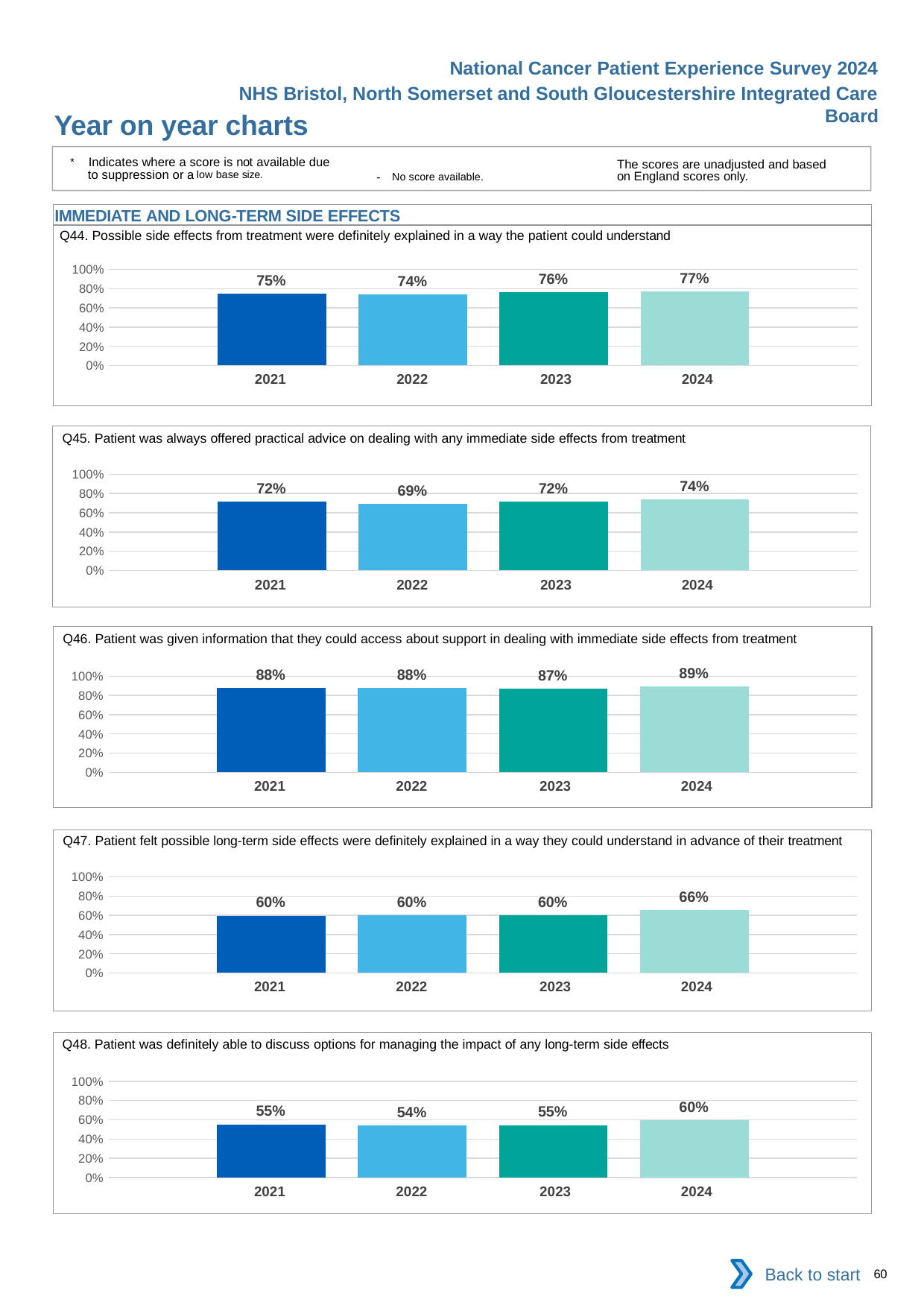
In the Q45 chart, is the value for 2021 larger or smaller than the value for 2022? larger In the Q44 chart, what is the difference between the 2023 value and the 2022 value? 2% In the Q48 chart, which year has the highest value? 2024 In the Q47 chart, what is the value for 2021? 60% How many years are shown in the Q44 chart? 4 In the Q44 chart, what is the value for 2024? 77% In the Q45 chart, which year has the lowest value? 2022 In the Q46 chart, what is the value for 2023? 87% How many charts are shown on the slide? 5 What kind of chart is the Q46 chart? bar chart In the Q47 chart, what is the difference between the 2024 value and the 2023 value? 6% In the Q48 chart, is the value for 2022 greater or less than 60%? less